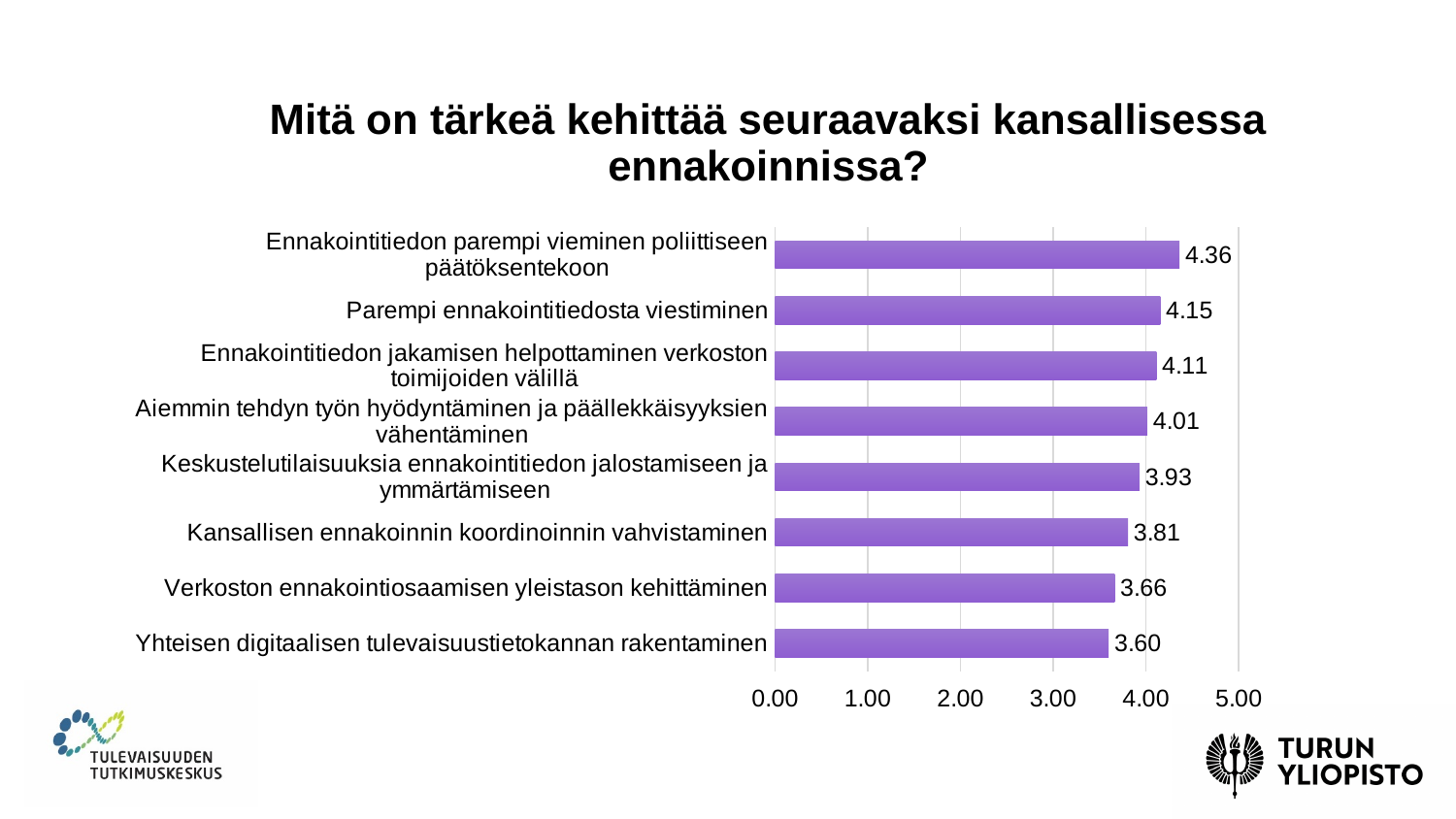
Which category has the lowest value? Yhteisen digitaalisen tulevaisuustietokannan rakentaminen Is the value for "Aiemmin tehdyn työn hyödyntäminen ja päällekkäisyyksien vähentäminen" greater or less than 3.00? greater What kind of chart is shown on the slide? Bar chart What is the difference between the values for "Ennakointitiedon parempi vieminen poliittiseen päätöksentekoon" and "Yhteisen digitaalisen tulevaisuustietokannan rakentaminen"? 0.76 What is the value for "Parempi ennakointitiedosta viestiminen"? 4.15 Which category has the highest value? Ennakointitiedon parempi vieminen poliittiseen päätöksentekoon What is the maximum value shown on the horizontal axis? 5.00 Which has a larger value: "Keskustelutilaisuuksia ennakointitiedon jalostamiseen ja ymmärtämiseen" or "Verkoston ennakointiosaamisen yleistason kehittäminen"? Keskustelutilaisuuksia ennakointitiedon jalostamiseen ja ymmärtämiseen How many categories are shown in the chart? 8 What is the title of the chart? Mitä on tärkeä kehittää seuraavaksi kansallisessa ennakoinnissa? What is the value for "Kansallisen ennakoinnin koordinoinnin vahvistaminen"? 3.81 What is the value for "Yhteisen digitaalisen tulevaisuustietokannan rakentaminen"? 3.60